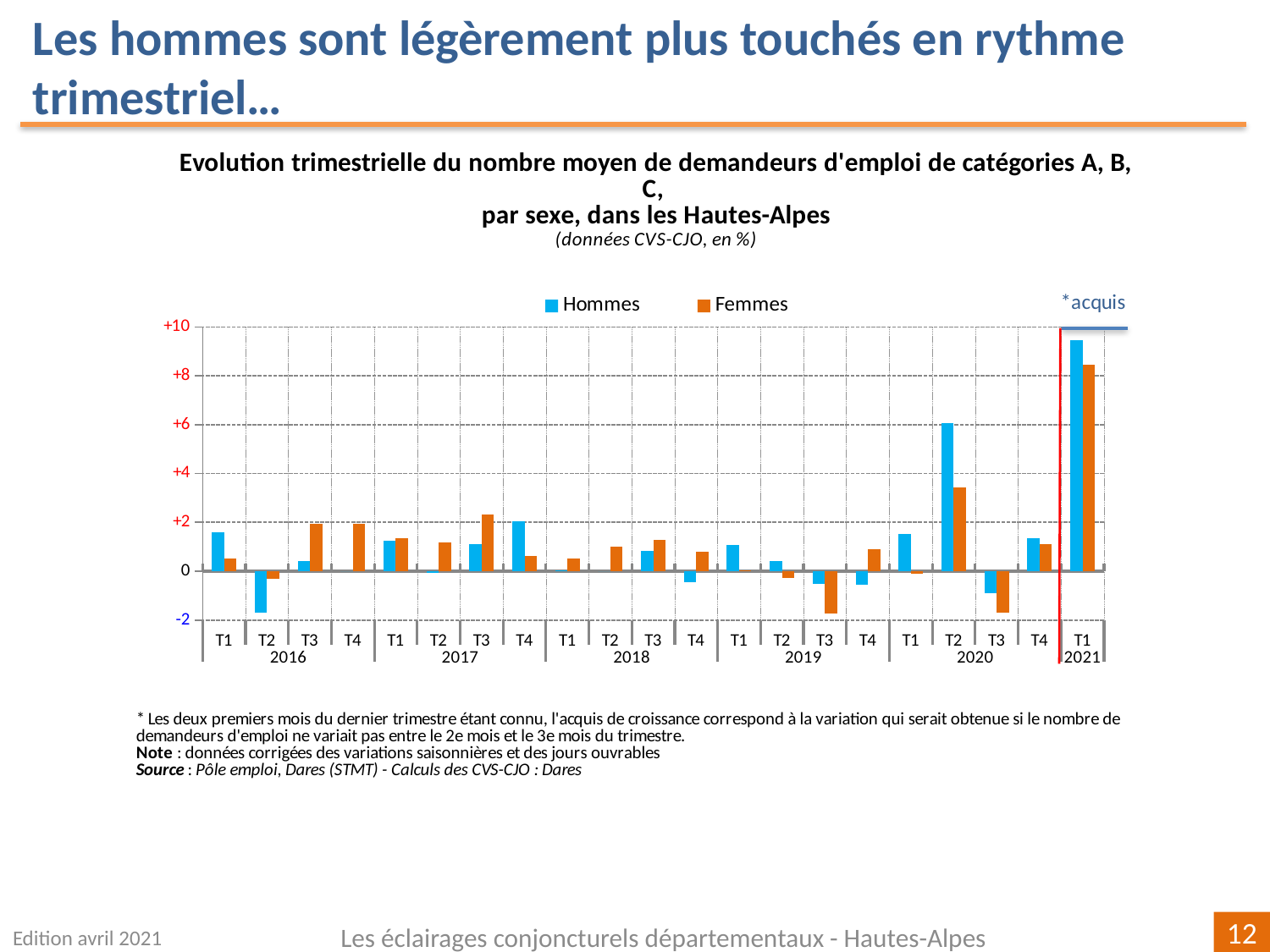
In T3 2017, which series has the larger value, Hommes or Femmes? Femmes In which quarter is the Femmes value highest? T1 2021 How many quarters (T1–T4 categories) are plotted along the x axis? 21 In which quarter is the Hommes value highest? T1 2021 In which quarter is the Hommes value lowest? T2 2016 Is the Femmes value for T1 2021 greater or less than +6? greater In T2 2020, which series has the larger value, Hommes or Femmes? Hommes Which two series are shown in the legend? Hommes and Femmes What kind of chart is shown on the slide? bar chart Is the Hommes value for T1 2021 greater or less than +8? greater How many series does the legend list? 2 Is the Hommes value for T2 2020 greater or less than +4? greater